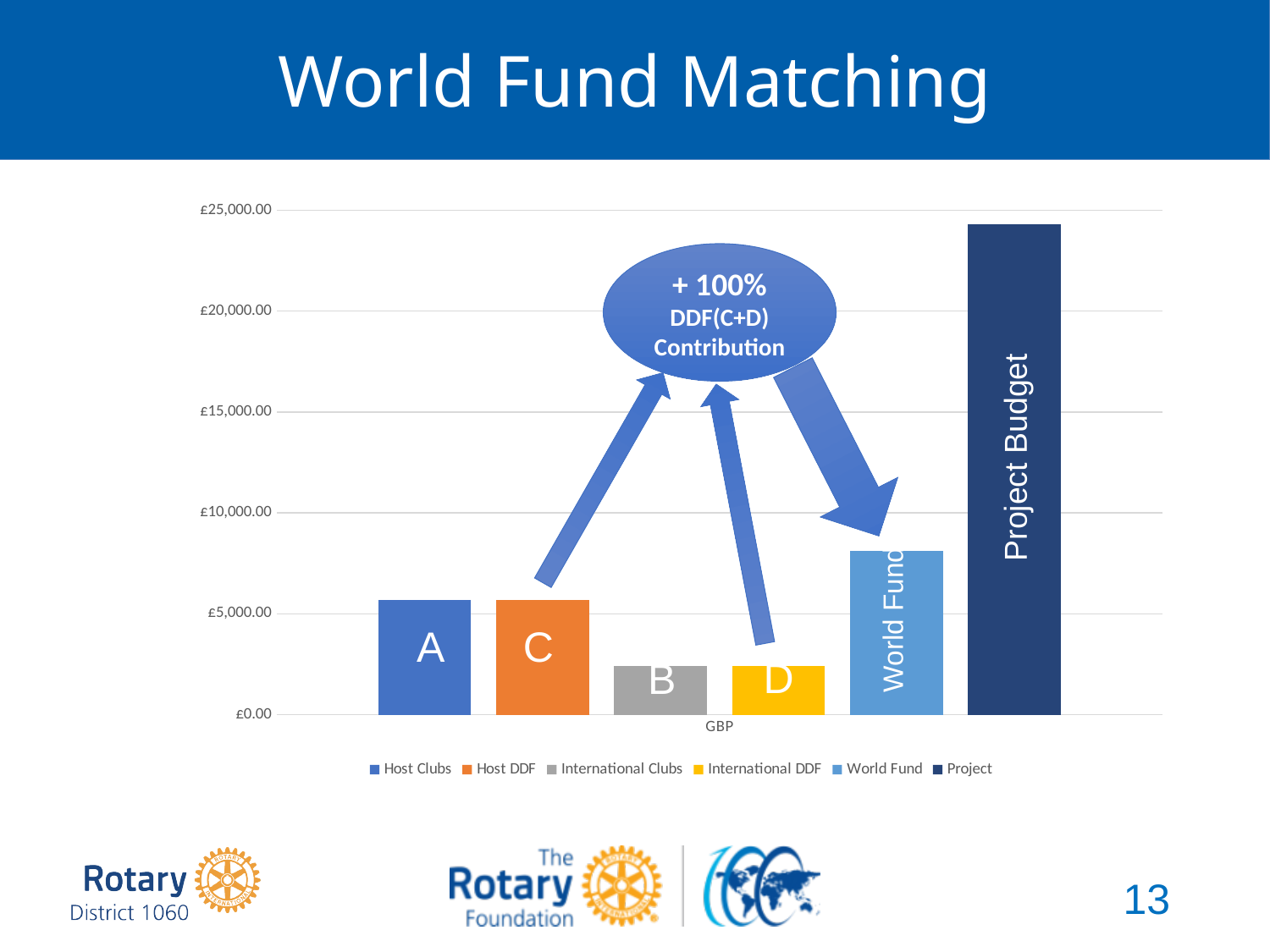
Is the value for the International Clubs bar (B) greater or less than £5,000.00? less Which is larger, the Host DDF bar (C) or the International DDF bar (D)? Host DDF Is the value for the World Fund bar greater or less than £10,000.00? less How many series does the legend list? 6 Is the value for the Host Clubs bar (A) greater or less than £5,000.00? greater Which is larger, the Project bar or the World Fund bar? Project What is the title of the slide containing the chart? World Fund Matching What kind of chart is shown on the slide? bar chart Which series has the tallest bar? Project What label appears on the x axis of the chart? GBP